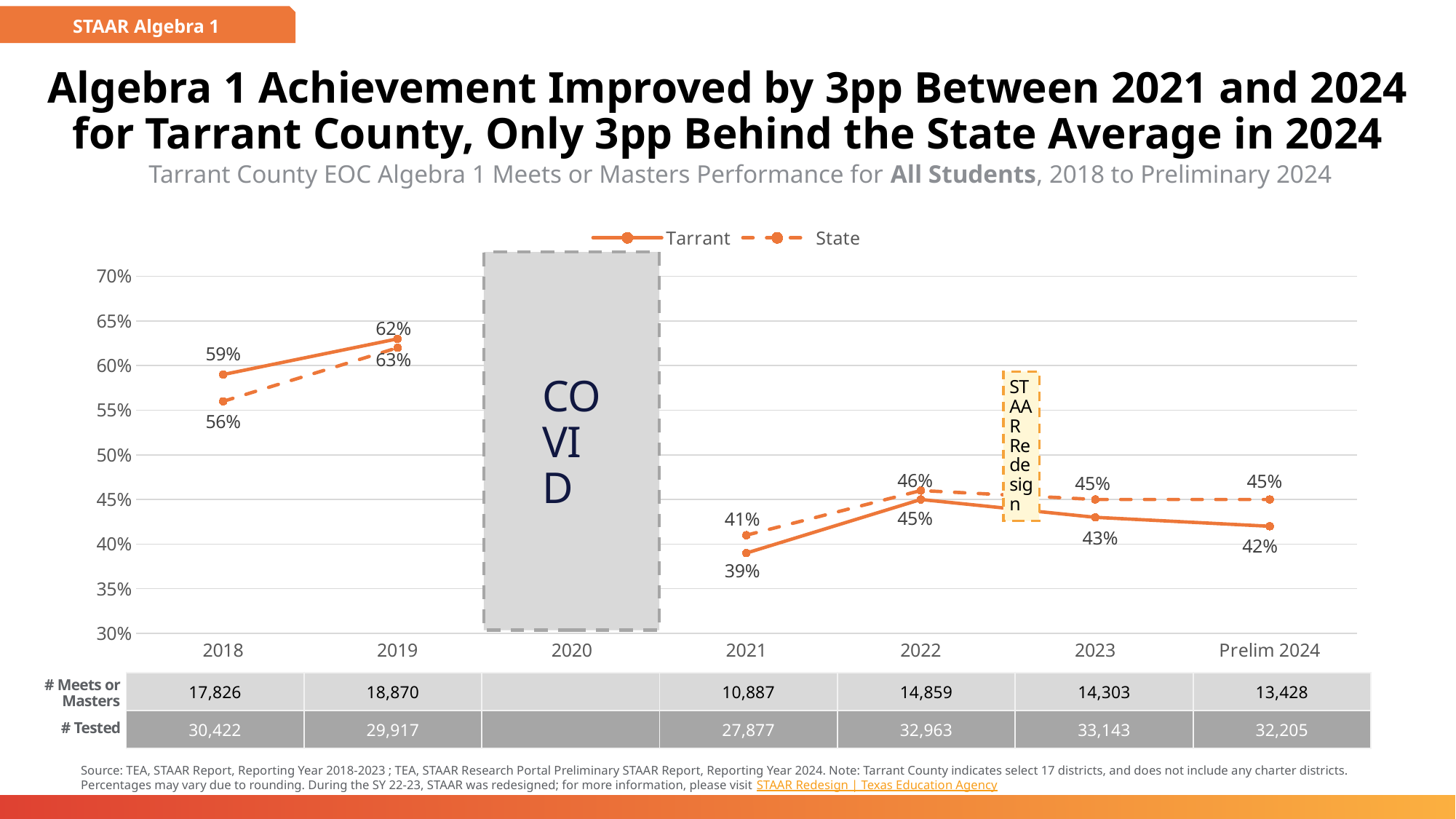
What is the State value for 2021? 41% How many year labels are shown on the x axis? 7 In which year is the Tarrant value lowest? 2021 Does the Tarrant line rise or fall from 2022 to Prelim 2024? fall In 2022, which is larger, the Tarrant value or the State value? State What is the Tarrant value for Prelim 2024? 42% What does the shaded box over 2020 indicate? COVID What is the Tarrant value for 2018? 59% What is the State value for 2023? 45% How many series does the legend list? 2 What is the difference between the State and Tarrant values in Prelim 2024? 3 percentage points What kind of chart is shown on the slide? line chart